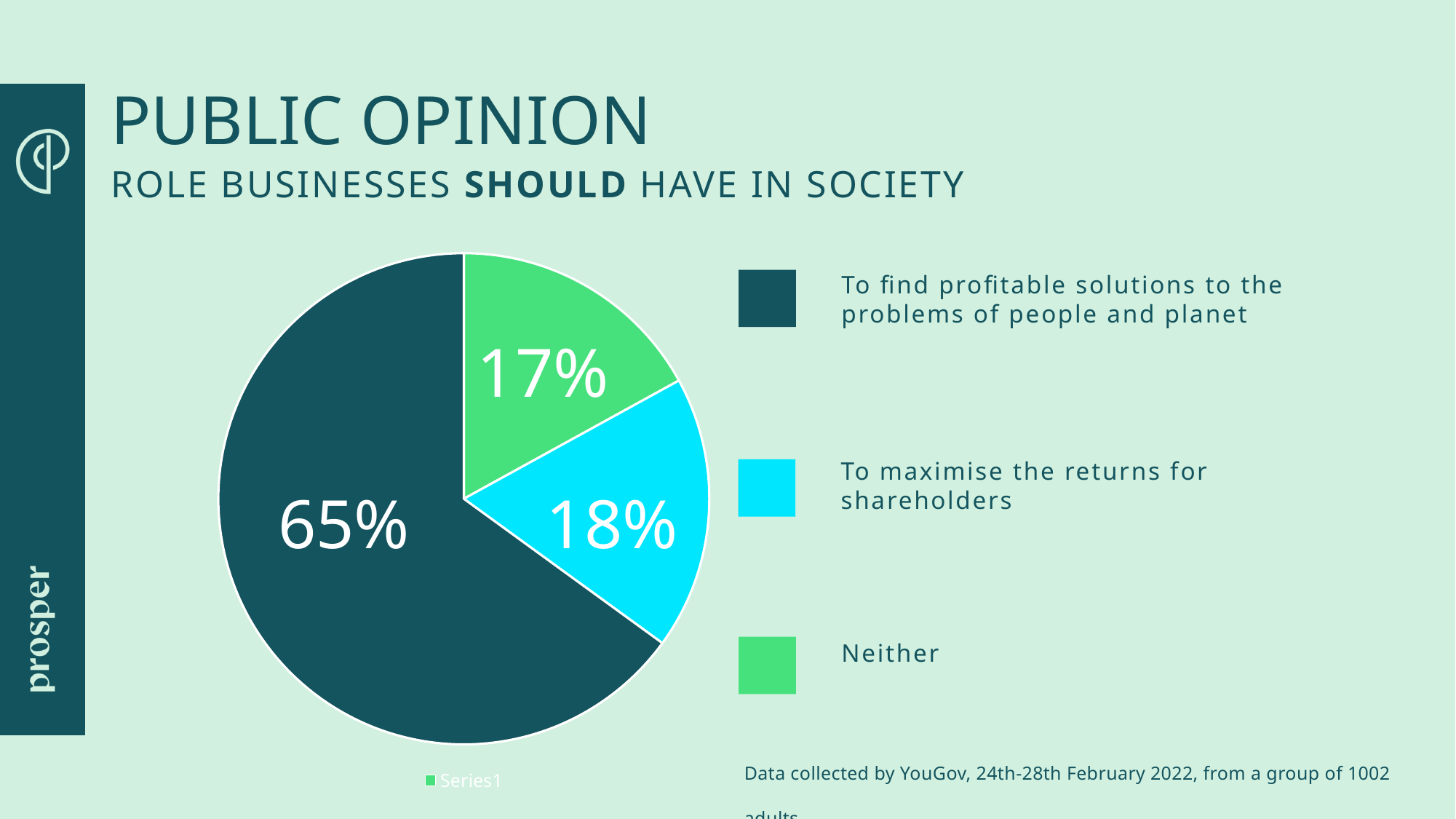
What is the difference in percentage points between the 'find profitable solutions' slice and the 'maximise the returns for shareholders' slice? 47 What share of respondents said businesses should maximise the returns for shareholders? 18% Which response has the smallest slice of the pie? Neither Which response has the largest slice of the pie? To find profitable solutions to the problems of people and planet Is the slice for 'To maximise the returns for shareholders' larger or smaller than the slice for 'To find profitable solutions to the problems of people and planet'? smaller What colour is the slice representing 'Neither'? green How many slices does the pie chart have? 3 What share of respondents said businesses should find profitable solutions to the problems of people and planet? 65% What kind of chart is shown on the slide? pie chart What series name is shown in the legend below the pie chart? Series1 What share of respondents answered 'Neither'? 17% What is the difference in percentage points between the 'maximise the returns for shareholders' slice and the 'Neither' slice? 1